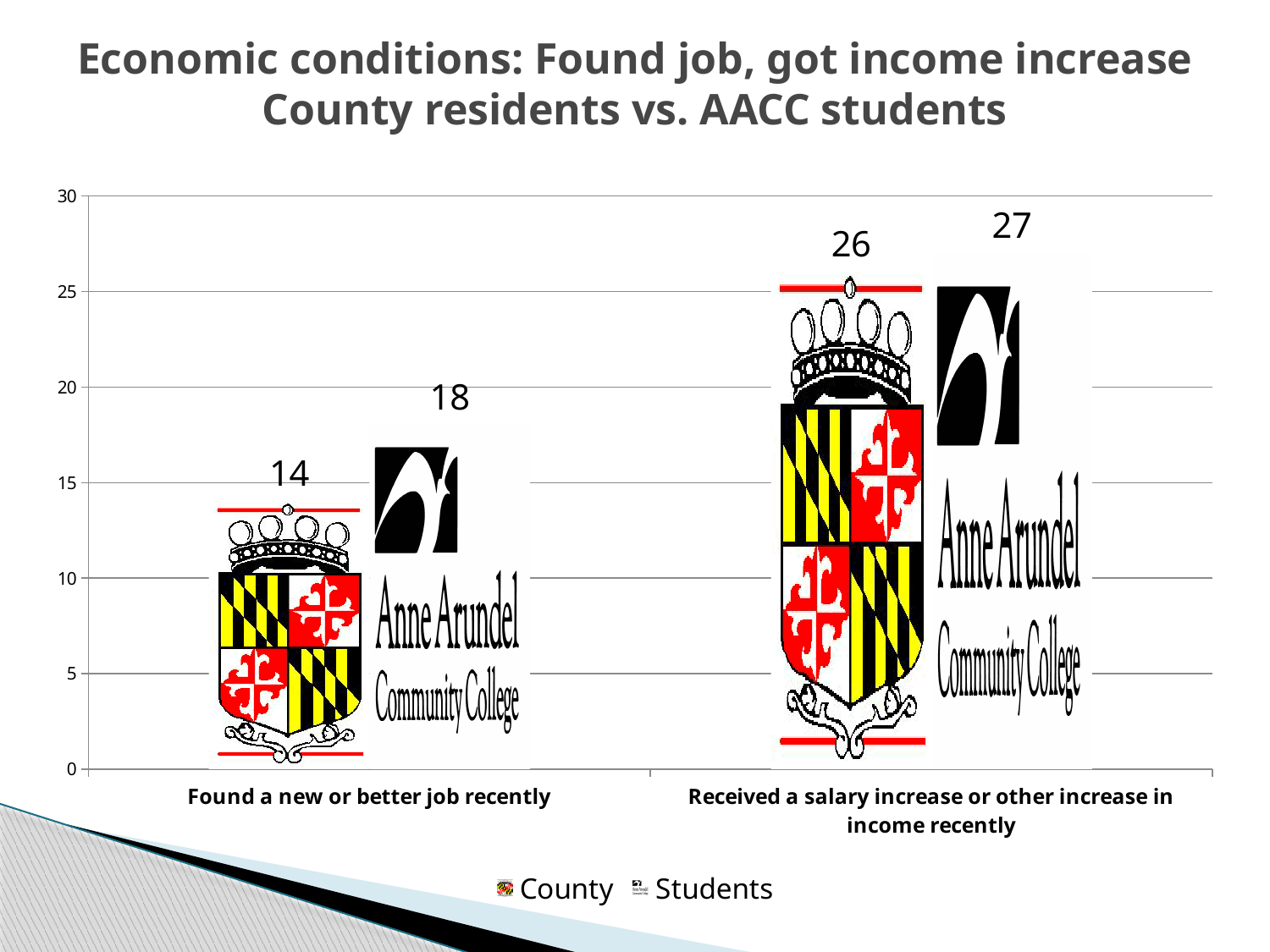
What is the difference between the Students and County values for 'Found a new or better job recently'? 4 Which category has the highest Students value? Received a salary increase or other increase in income recently How many series does the legend list? 2 How many categories are shown on the x axis? 2 What is the Students value for 'Received a salary increase or other increase in income recently'? 27 What is the Students value for 'Found a new or better job recently'? 18 What is the difference between the County values for the two categories? 12 Which category has the lowest County value? Found a new or better job recently What kind of chart is shown on the slide? Bar chart What is the County value for 'Found a new or better job recently'? 14 Which is larger for 'Found a new or better job recently': the County value or the Students value? Students What is the County value for 'Received a salary increase or other increase in income recently'? 26